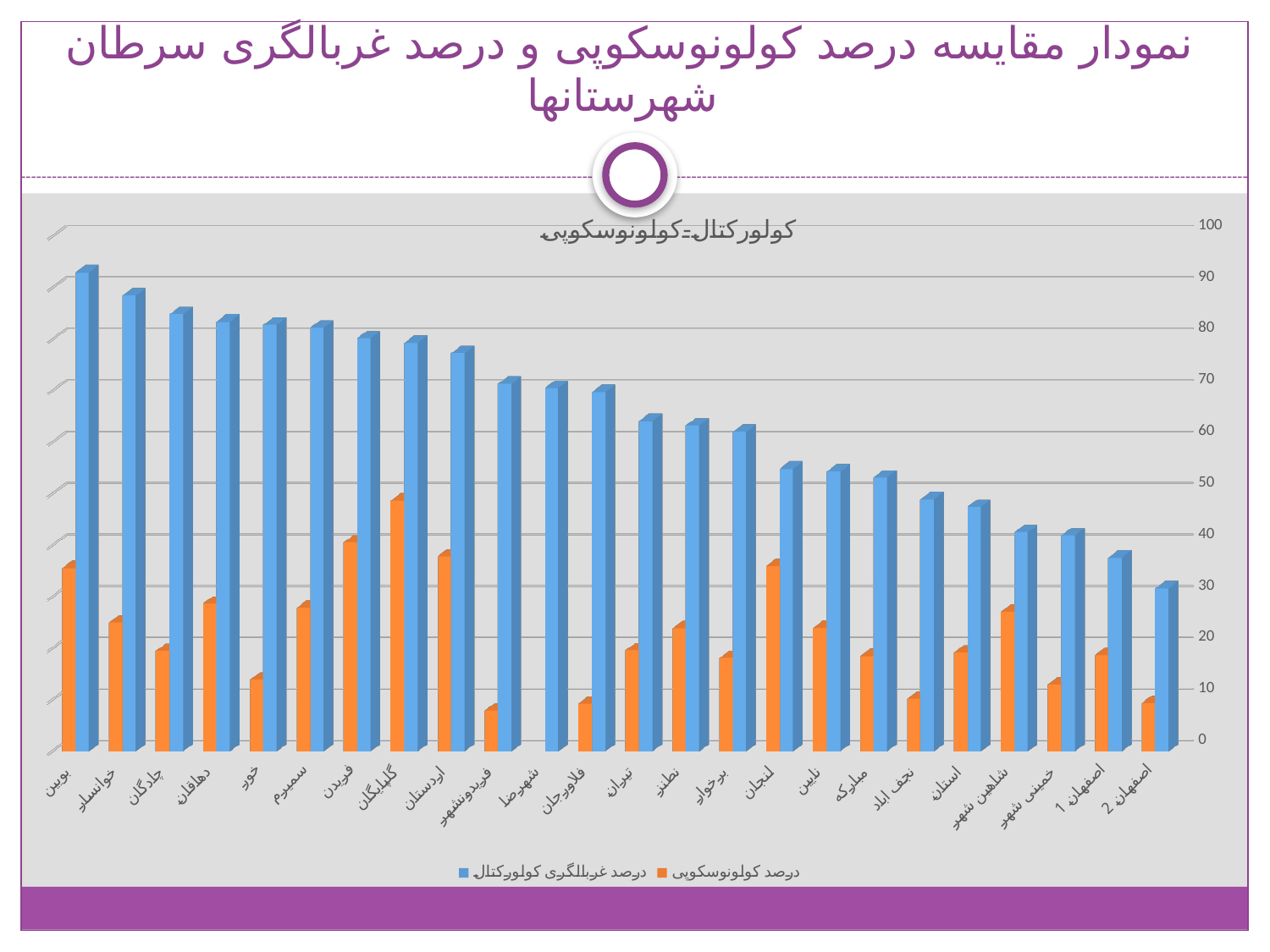
How many categories (cities) are shown on the x axis? 24 Is the orange-series value for خور greater or less than 20? less Which has the larger blue-series value, اصفهان 1 or اصفهان 2? اصفهان 1 How many series does the legend list? 2 Which category has the highest value for درصد غربالگری کولورکتال (blue series)? بویین Which category has the highest value for درصد کولونوسکوپی (orange series)? گلپایگان Do the values of the blue series (درصد غربالگری کولورکتال) rise or fall from left to right along the x axis? fall Is the orange-series value for گلپایگان greater or less than 40? greater What kind of chart is shown on the slide? bar chart Is the blue-series value for خوانسار greater or less than 80? greater Which category has the lowest value for درصد غربالگری کولورکتال (blue series)? اصفهان 2